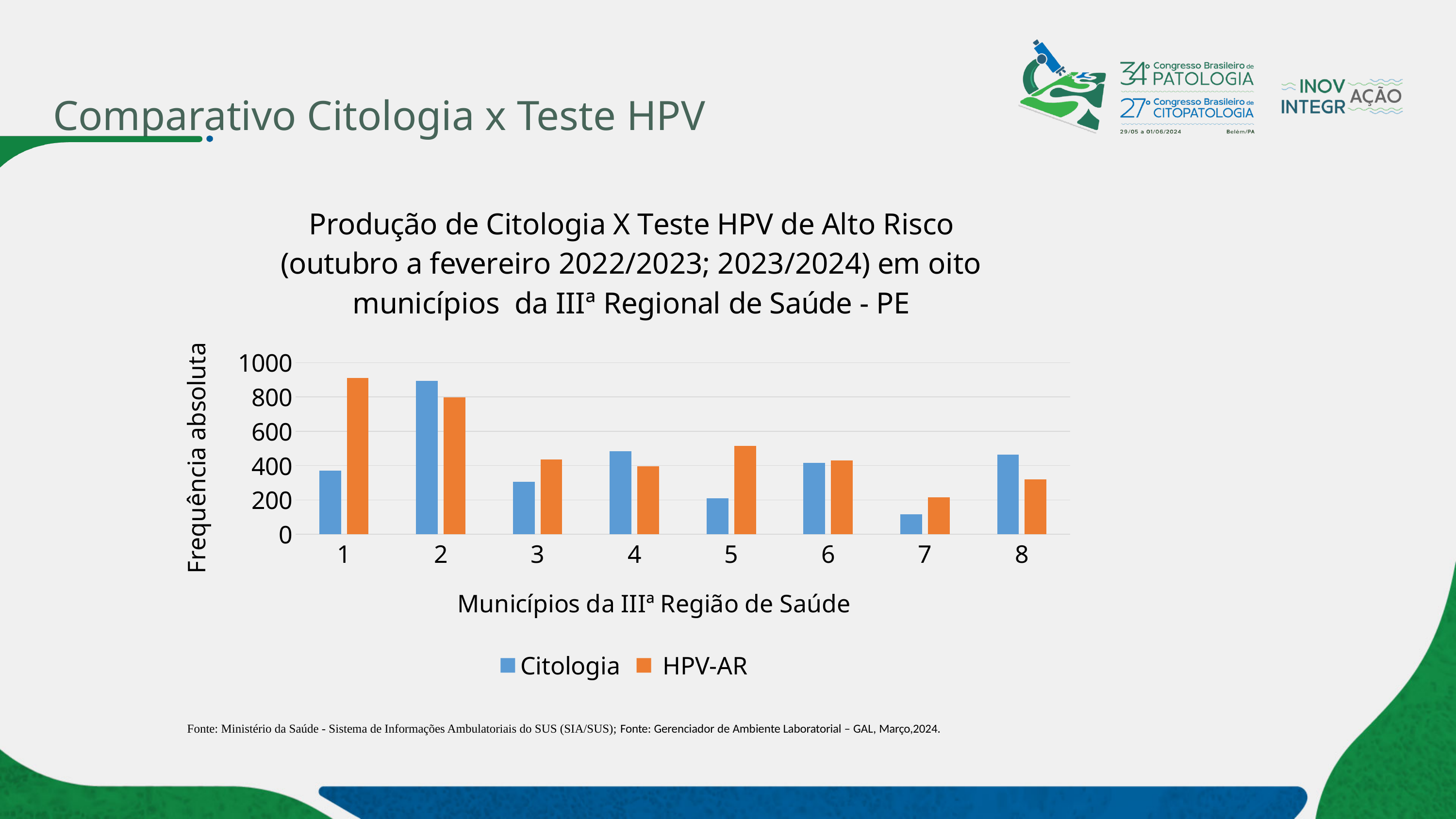
Is the HPV-AR value for municipality 1 greater or less than 800? greater Which municipality has the lowest Citologia value? 7 How many series does the legend list? 2 For municipality 8, which is larger: Citologia or HPV-AR? Citologia Which municipality has the lowest HPV-AR value? 7 How many municipalities (categories) are shown on the x axis? 8 For municipality 1, which is larger: Citologia or HPV-AR? HPV-AR Which municipality has the highest HPV-AR value? 1 Which municipality has the highest Citologia value? 2 What is the label of the y axis? Frequência absoluta Is the Citologia value for municipality 7 greater or less than 200? less What kind of chart is shown on the slide? bar chart